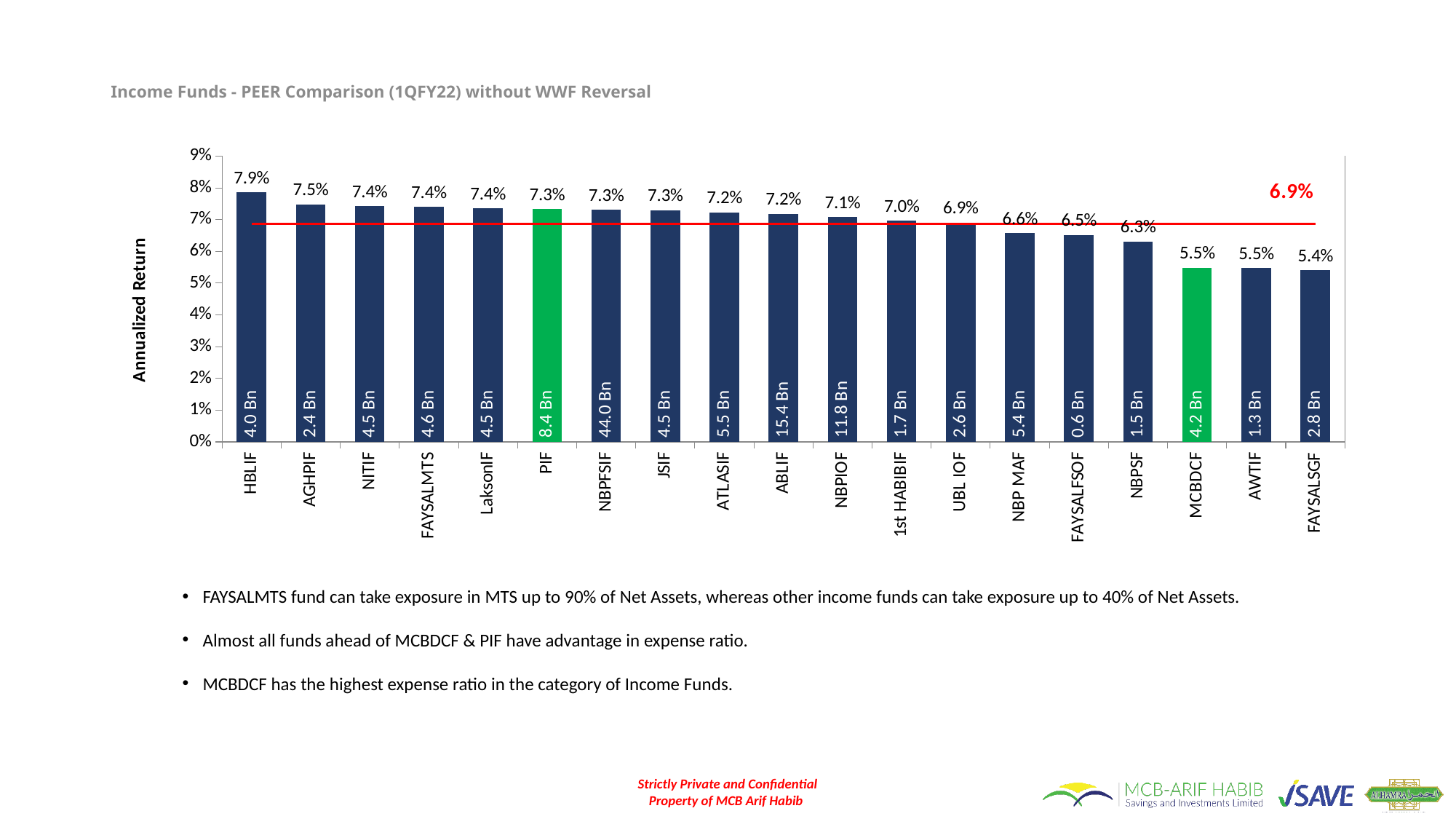
Is the annualized return for AWTIF greater or less than 6%? less What value is marked by the red horizontal line on the chart? 6.9% Which fund has the highest annualized return? HBLIF What is the annualized return for MCBDCF? 5.5% Which has a higher annualized return, AGHPIF or NBP MAF? AGHPIF What is the annualized return for HBLIF? 7.9% What is the difference between the annualized return of HBLIF and FAYSALSGF? 2.5% Which fund has the lowest annualized return? FAYSALSGF How many funds are shown on the chart? 19 What fund size (in Bn) is shown inside the bar for NBPFSIF? 44.0 Bn What type of chart is used on this slide? Bar chart What is the annualized return for NBPSF? 6.3%